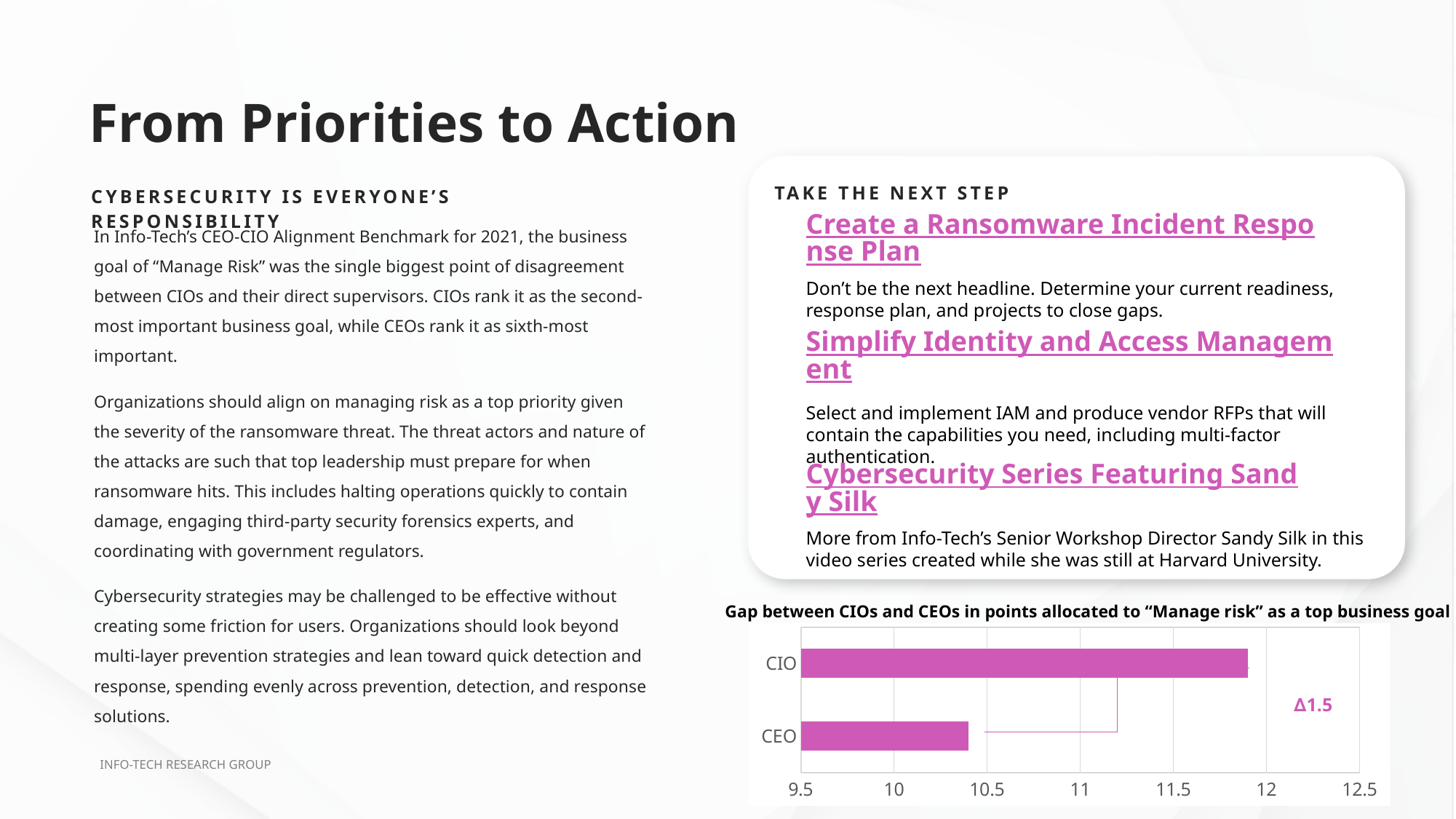
Is the value for CEO greater or less than 10? greater Is the CIO value larger or smaller than the CEO value? larger What is the lowest value shown on the chart's horizontal axis? 9.5 Is the value for CIO greater or less than 12? less Is the value for CIO greater or less than 11.5? greater Which category has the shorter bar in the chart? CEO What gap between the CIO and CEO values is labelled on the chart? Δ1.5 What is the title of the chart on the slide? Gap between CIOs and CEOs in points allocated to “Manage risk” as a top business goal Which category has the longer bar in the chart, CIO or CEO? CIO How many categories are plotted in the chart? 2 What type of chart is shown at the bottom right of the slide? bar chart